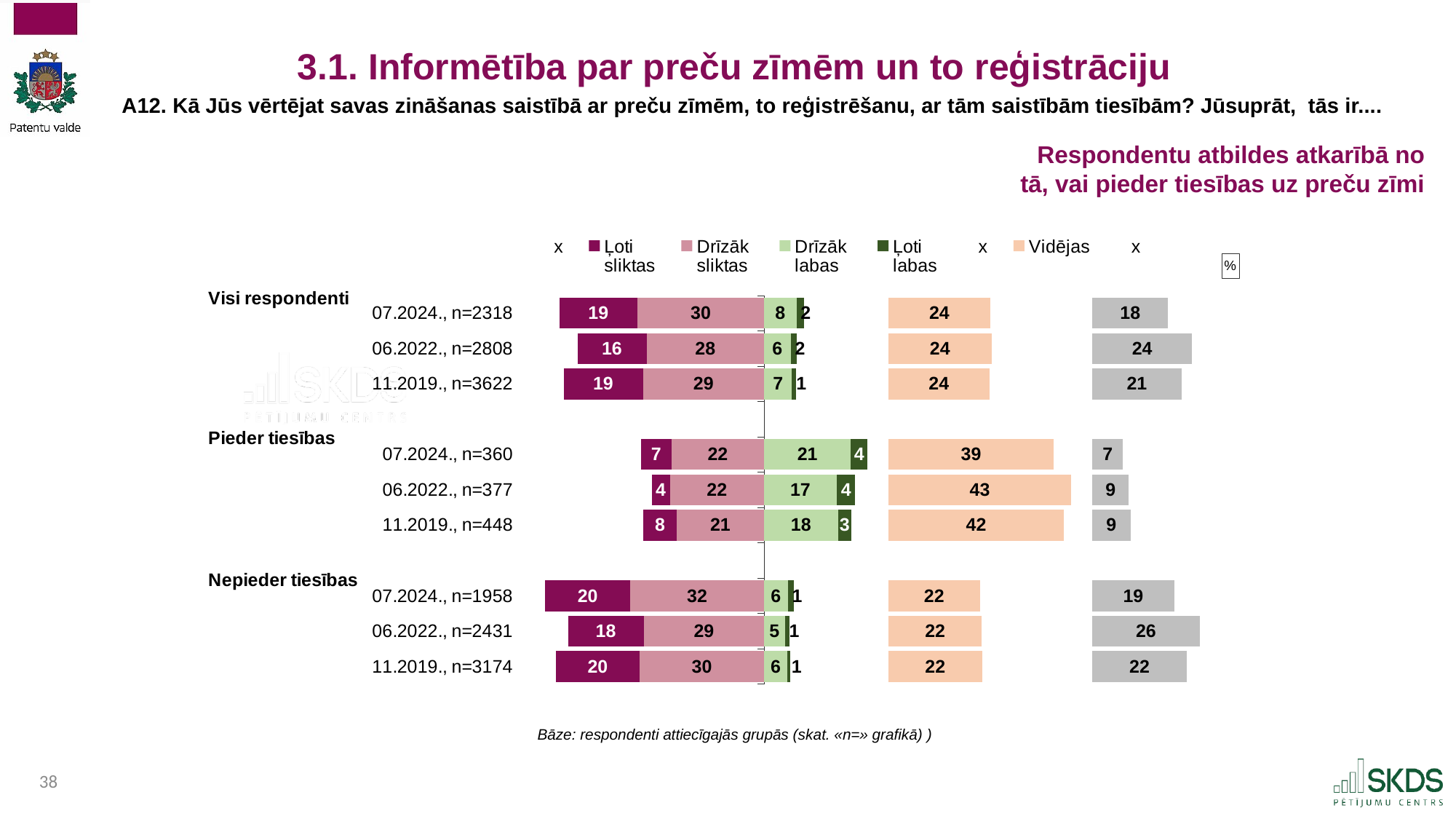
What is the combined value of Ļoti sliktas and Drīzāk sliktas for Visi respondenti, 07.2024., n=2318? 49 How many bars (rows) are plotted in the chart? 9 What is the value of Ļoti sliktas for Nepieder tiesības, 07.2024., n=1958? 20 What type of chart is shown on the slide? Stacked bar chart What is the value of Vidējas for Pieder tiesības, 06.2022., n=377? 43 For Pieder tiesības, is the Drīzāk labas value larger in 07.2024., n=360 or in 06.2022., n=377? 07.2024., n=360 Among the Pieder tiesības rows, which survey wave has the highest Vidējas value? 06.2022., n=377 Across all rows, which row has the highest Drīzāk sliktas value? Nepieder tiesības, 07.2024., n=1958 Across all rows, which row has the lowest Ļoti sliktas value? Pieder tiesības, 06.2022., n=377 What is the value of Ļoti labas for Pieder tiesības, 11.2019., n=448? 3 What is the subtitle shown above the chart on the right? Respondentu atbildes atkarībā no tā, vai pieder tiesības uz preču zīmi What is the difference between the Drīzāk sliktas value for Nepieder tiesības 07.2024., n=1958 and for Visi respondenti 07.2024., n=2318? 2